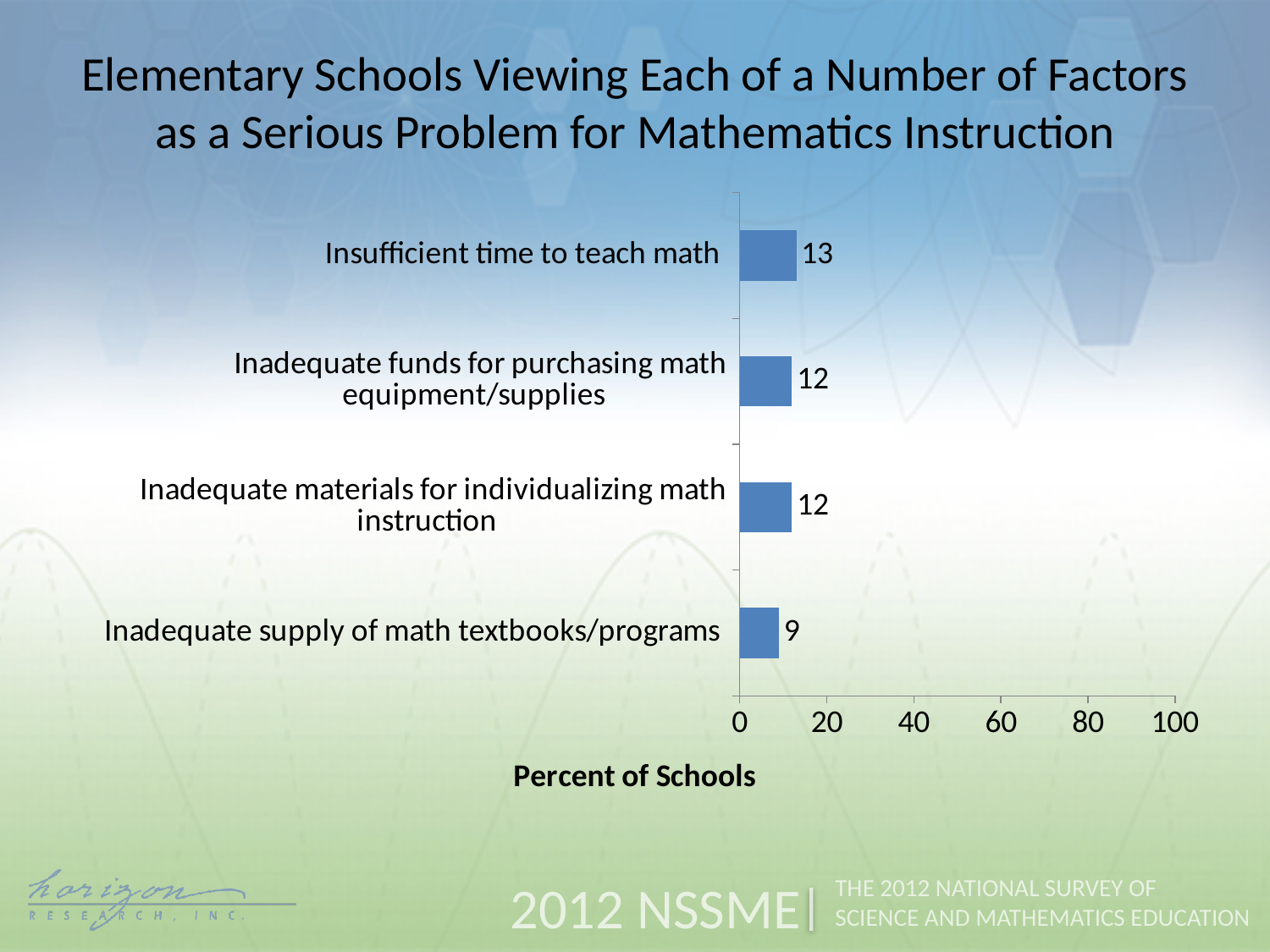
What is the value for inadequate funds for purchasing math equipment/supplies? 12 What is the value for inadequate supply of math textbooks/programs? 9 Is the value for insufficient time to teach math greater or less than 20? less How many factors are shown in the chart? 4 What is the label of the horizontal axis? Percent of Schools Which factor has the highest percent of schools viewing it as a serious problem? Insufficient time to teach math What is the difference between the values for insufficient time to teach math and inadequate supply of math textbooks/programs? 4 What percent of schools view insufficient time to teach math as a serious problem? 13 Which is larger: the value for inadequate materials for individualizing math instruction or the value for inadequate supply of math textbooks/programs? Inadequate materials for individualizing math instruction Which factor has the lowest percent of schools viewing it as a serious problem? Inadequate supply of math textbooks/programs What is the maximum value shown on the horizontal axis? 100 What kind of chart is shown on the slide? Bar chart